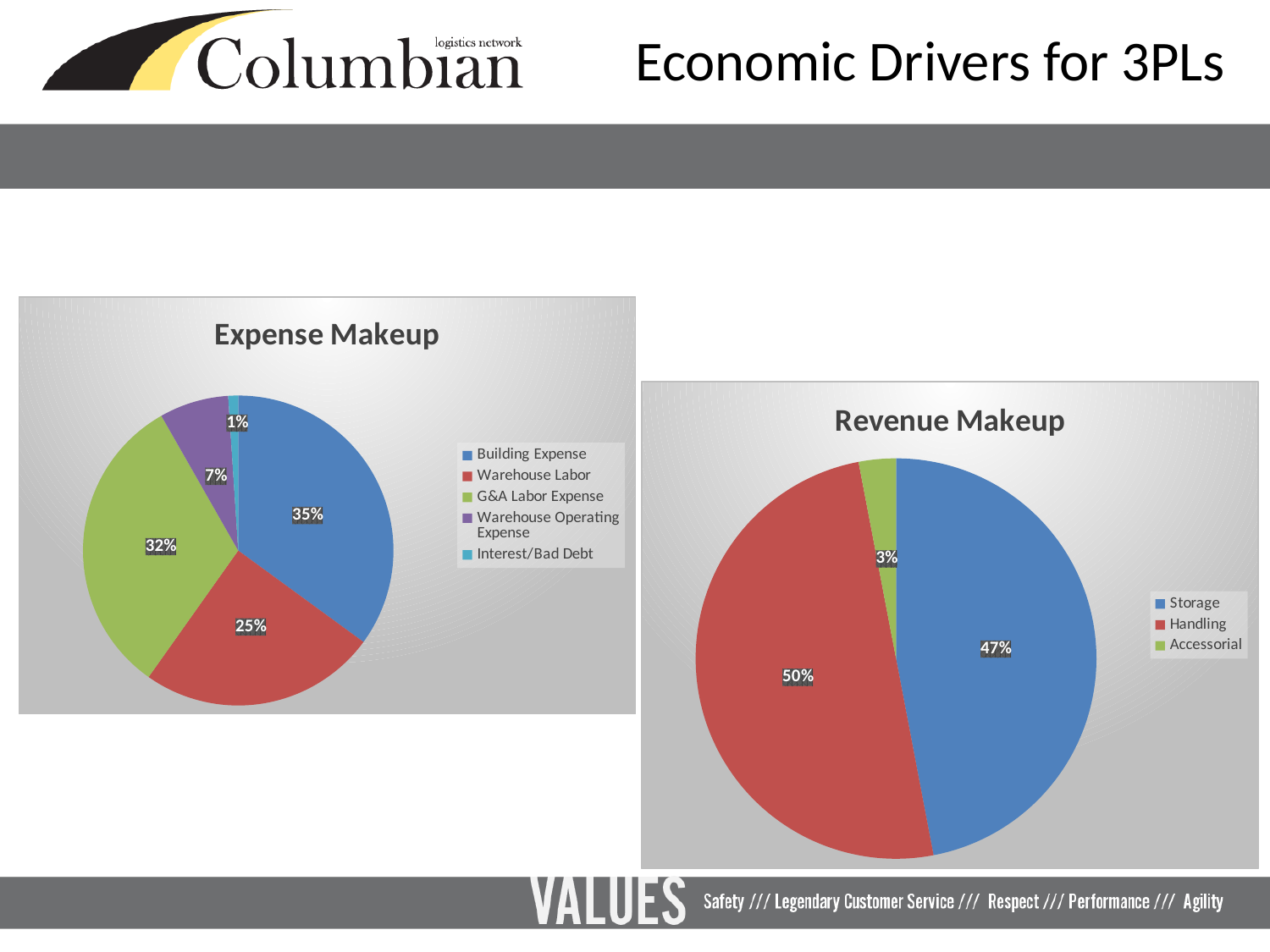
In the Expense Makeup chart, which category has the smallest share? Interest/Bad Debt In the Expense Makeup chart, which category has the largest share? Building Expense In the Revenue Makeup chart, what share does Accessorial have? 3% In the Expense Makeup chart, what share does Warehouse Operating Expense have? 7% In the Expense Makeup chart, what is the difference between the Building Expense and Warehouse Labor shares? 10% In the Expense Makeup chart, how many categories are shown? 5 In the Expense Makeup chart, what share does G&A Labor Expense have? 32% In the Revenue Makeup chart, what share does Handling have? 50% In the Expense Makeup chart, what share does Building Expense have? 35% What type of chart is the Revenue Makeup chart? Pie chart In the Revenue Makeup chart, which is larger, Storage or Handling? Handling In the Revenue Makeup chart, how many categories does the legend list? 3